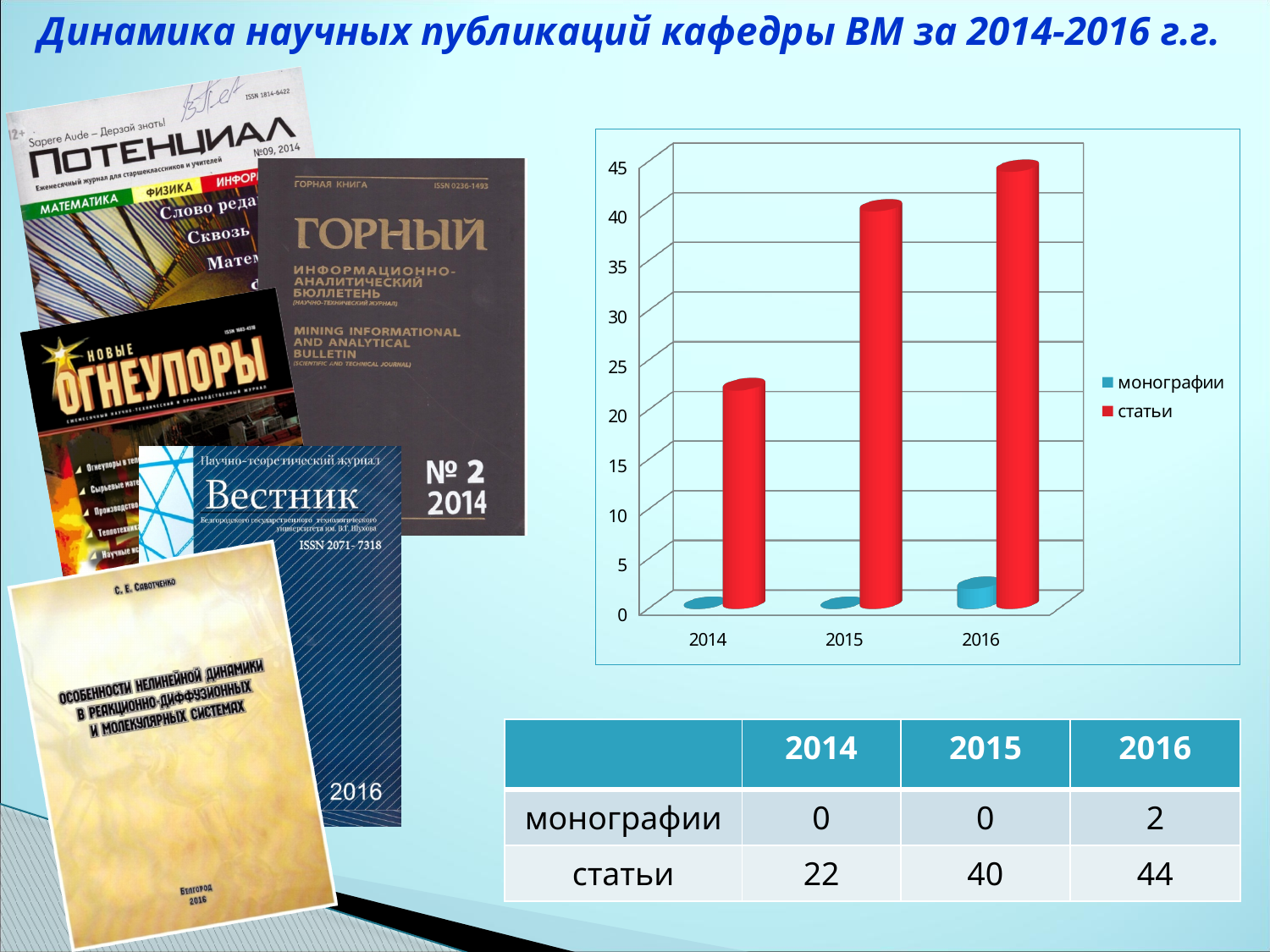
What is the value for монографии in 2016? 2 What is the value for статьи in 2015? 40 Which is larger, the статьи value for 2015 or for 2014? 2015 Do the статьи values rise or fall from 2014 to 2016? rise How many series does the chart legend list? 2 What kind of chart is shown on the slide? bar chart In which year is the value for статьи highest? 2016 What is the difference between the статьи values for 2016 and 2014? 22 In which year is the value for статьи lowest? 2014 What is the value for статьи in 2014? 22 How many years are shown on the x axis of the chart? 3 Is the value for статьи in 2015 greater or less than 35? greater